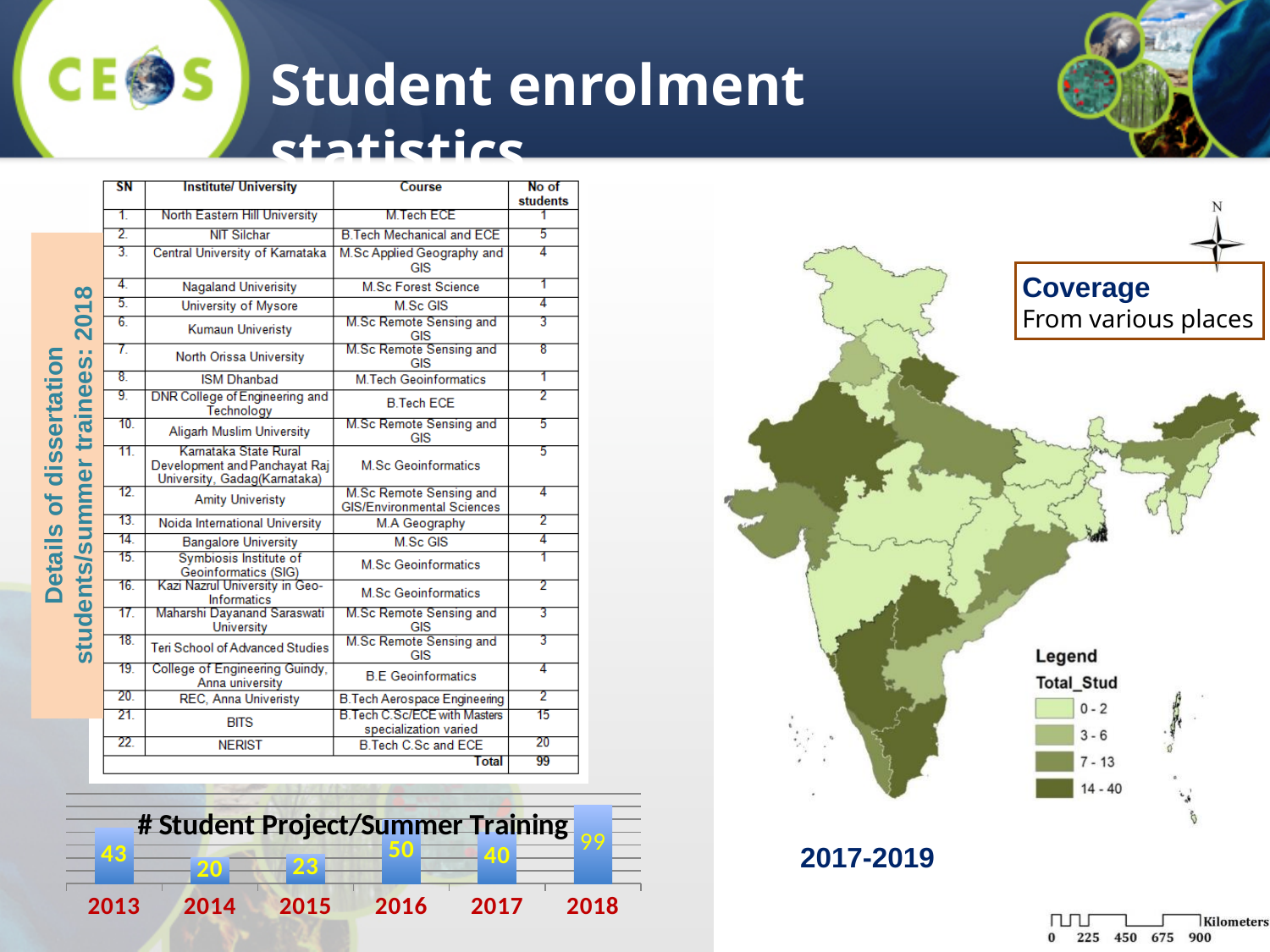
What kind of chart is the '# Student Project/Summer Training' chart? bar chart In the '# Student Project/Summer Training' chart, which year has a larger value, 2013 or 2016? 2016 In the '# Student Project/Summer Training' chart, what is the value for 2013? 43 In the '# Student Project/Summer Training' chart, what is the difference between the values for 2018 and 2017? 59 What is the title of the bar chart at the bottom left of the slide? # Student Project/Summer Training In the '# Student Project/Summer Training' chart, which year has the highest value? 2018 In the '# Student Project/Summer Training' chart, what is the difference between the values for 2015 and 2014? 3 In the '# Student Project/Summer Training' chart, which year has the lowest value? 2014 In the '# Student Project/Summer Training' chart, what is the value for 2016? 50 In the '# Student Project/Summer Training' chart, did the value rise or fall from 2017 to 2018? rise How many years are shown on the x axis of the '# Student Project/Summer Training' chart? 6 In the '# Student Project/Summer Training' chart, what is the value for 2017? 40